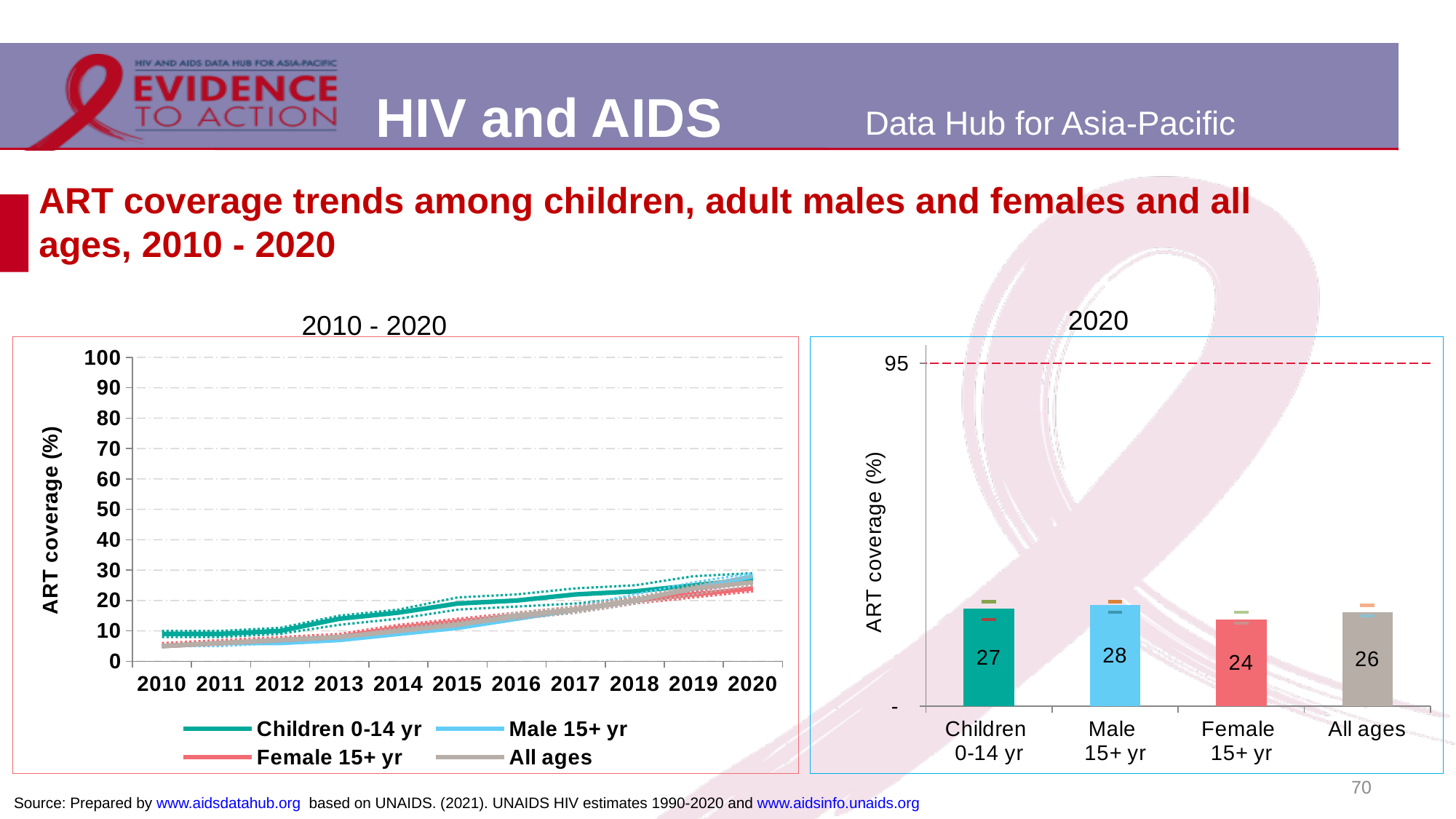
In the 2010 - 2020 line chart, does ART coverage for Children 0-14 yr rise or fall from 2010 to 2020? rise In the 2020 bar chart, what is the ART coverage for Children 0-14 yr? 27 In the 2020 bar chart, which category has the lowest ART coverage? Female 15+ yr What kind of chart is the 2010 - 2020 chart on the left? line chart In the 2020 bar chart, what is the ART coverage for Male 15+ yr? 28 In the 2020 bar chart, what is the ART coverage for All ages? 26 In the 2020 bar chart, what is the ART coverage for Female 15+ yr? 24 In the 2010 - 2020 line chart, how many series does the legend list? 4 In the 2020 bar chart, how many categories are shown? 4 In the 2020 bar chart, what value does the dashed red reference line mark? 95 In the 2020 bar chart, what is the difference between the ART coverage for Male 15+ yr and Female 15+ yr? 4 In the 2020 bar chart, which category has the highest ART coverage? Male 15+ yr